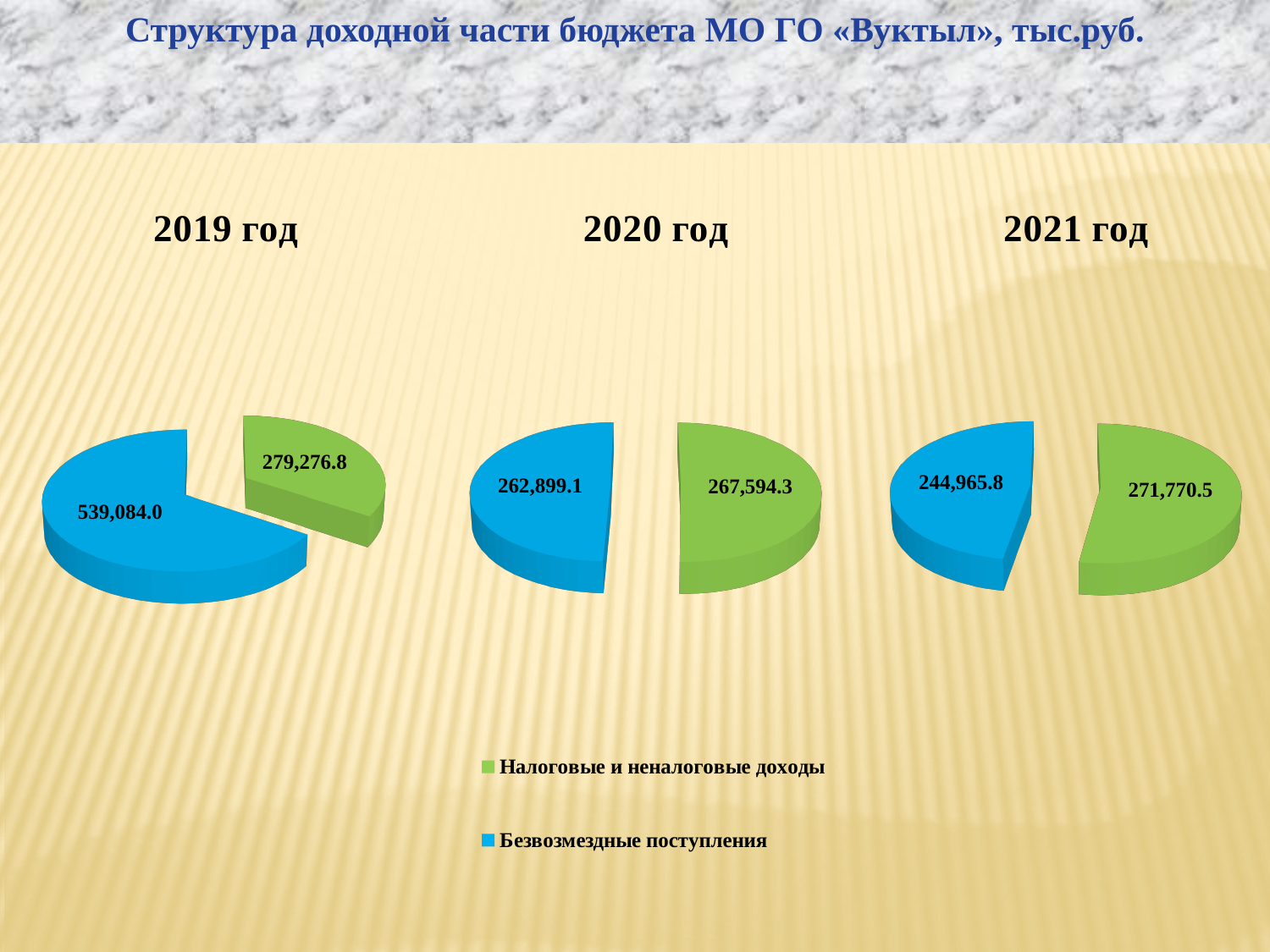
In the 2020 год pie chart, what is the value for Налоговые и неналоговые доходы? 267,594.3 What kind of chart is used for each year on the slide? pie chart In the 2019 год pie chart, what is the value for Безвозмездные поступления? 539,084.0 What is the total of the two slices in the 2020 год pie chart? 530,493.4 In the 2021 год pie chart, which category has the smaller value? Безвозмездные поступления In the 2020 год pie chart, is the value for Налоговые и неналоговые доходы larger or smaller than the value for Безвозмездные поступления? larger In the 2019 год pie chart, which category has the larger value? Безвозмездные поступления In the 2021 год pie chart, what is the difference between Налоговые и неналоговые доходы and Безвозмездные поступления? 26,804.7 In the 2019 год pie chart, what is the difference between Безвозмездные поступления and Налоговые и неналоговые доходы? 259,807.2 In the 2019 год pie chart, what is the value for Налоговые и неналоговые доходы? 279,276.8 How many series does the legend list? 2 In the 2021 год pie chart, what is the value for Безвозмездные поступления? 244,965.8